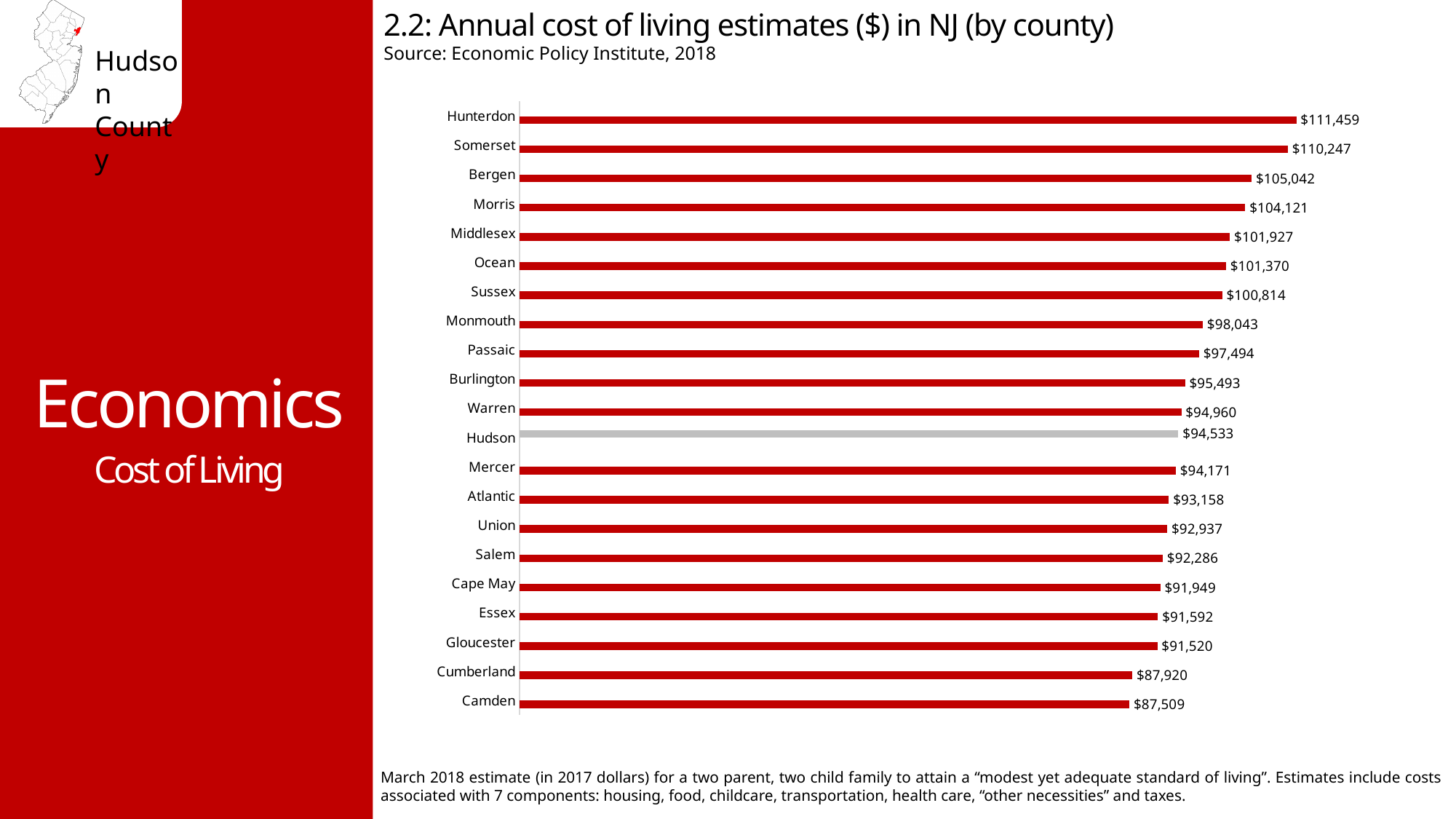
Which county has the highest annual cost of living estimate? Hunterdon Which county's bar is shown in grey instead of red? Hudson What is the annual cost of living estimate for Hudson County? $94,533 Which has a higher cost of living estimate, Essex or Gloucester? Essex What type of chart is used to show the cost of living estimates? Bar chart Which has a higher cost of living estimate, Bergen or Morris? Bergen How many counties are shown in the chart? 21 What is the annual cost of living estimate for Cumberland County? $87,920 What is the annual cost of living estimate for Bergen County? $105,042 How much higher is the cost of living estimate for Hudson than for Camden? $7,024 What is the difference between the cost of living estimates for Hunterdon and Camden? $23,950 Which county has the lowest annual cost of living estimate? Camden